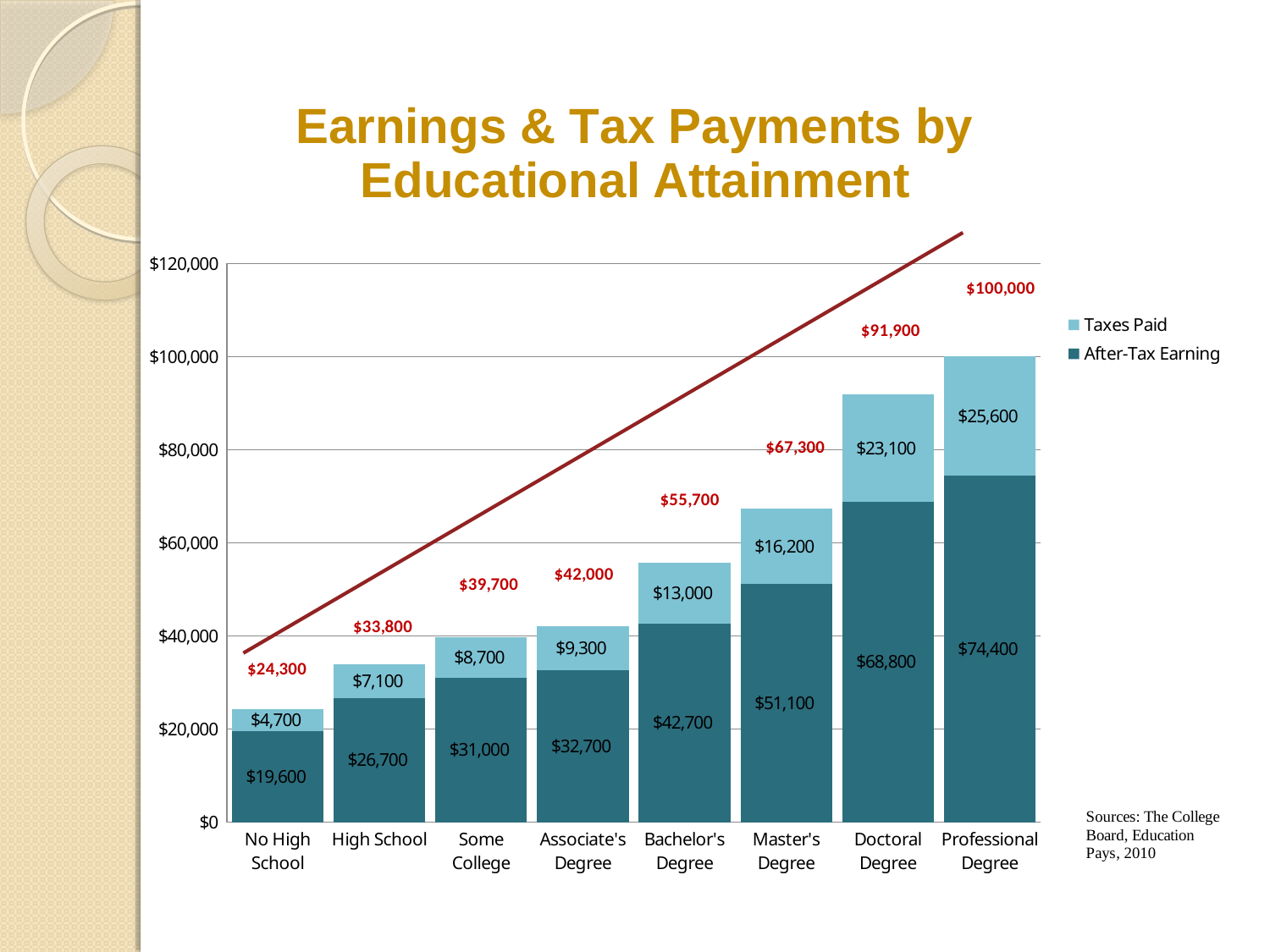
How many series does the legend list? 2 What is the total labeled above the bar for a Master's Degree? $67,300 How many educational attainment categories are shown on the x axis? 8 What is the After-Tax Earning value for a Bachelor's Degree? $42,700 What is the total of the stacked bar for High School? $33,800 What is the difference between the After-Tax Earning for a Professional Degree and for a Doctoral Degree? $5,600 Do the total earnings rise or fall as educational attainment increases from left to right? Rise What is the Taxes Paid value for a Doctoral Degree? $23,100 What kind of chart is shown on the slide? Stacked bar chart Which educational attainment category has the lowest Taxes Paid value? No High School Which is larger, the Taxes Paid for Some College or the Taxes Paid for an Associate's Degree? Associate's Degree Which educational attainment category has the highest total earnings? Professional Degree